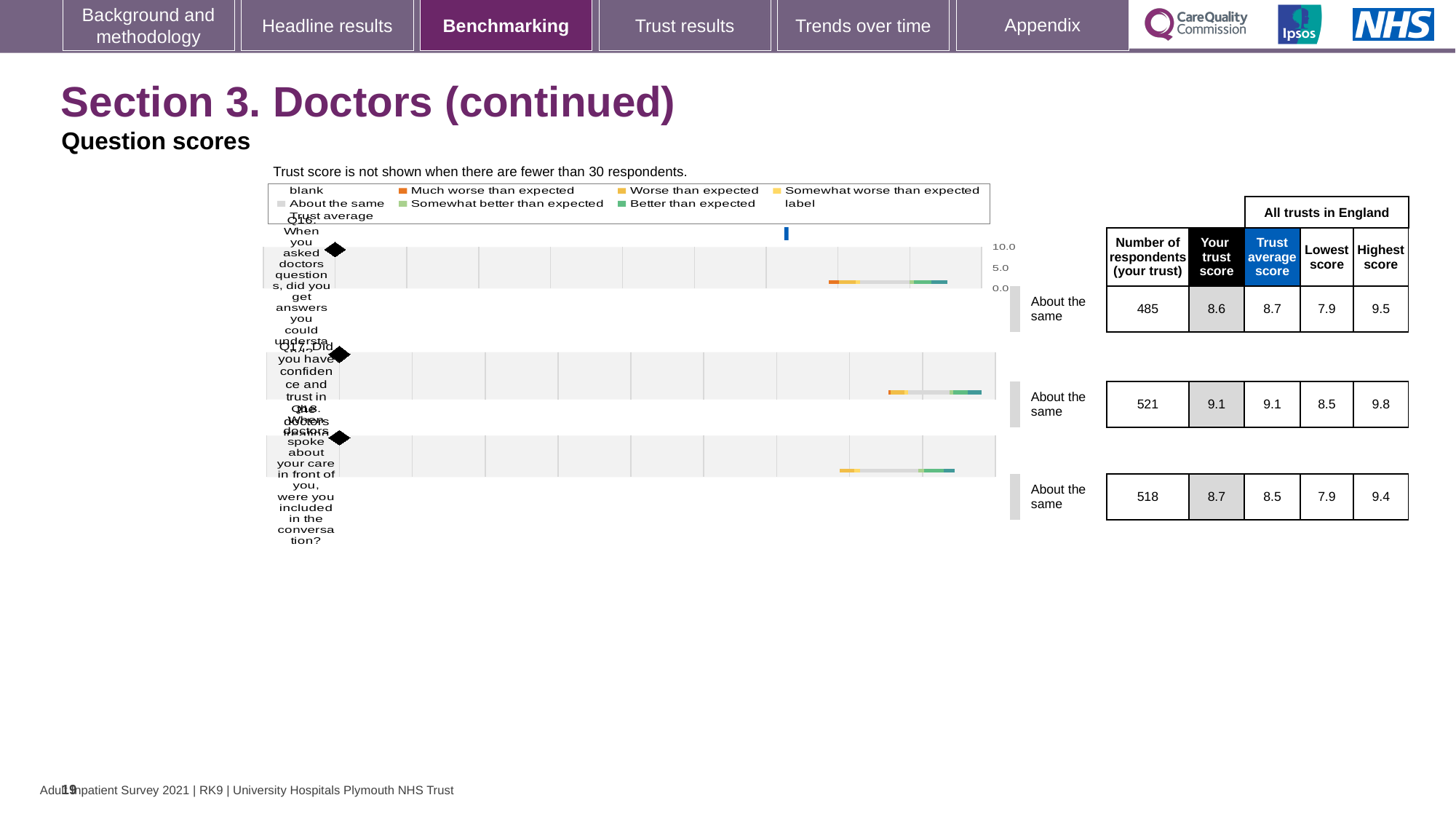
Which question has the fewest respondents from your trust? Q16 What is the highest score across all trusts in England for Q18 (being included in the conversation when doctors spoke about your care)? 9.4 What is the difference between the highest score and the lowest score for Q16? 1.6 What benchmark category is shown for Q16? About the same How many respondents from your trust answered Q16 (getting answers you could understand from doctors)? 485 Which question has the highest 'Your trust score'? Q17 How many questions are shown in the chart? 3 What is the lowest score across all trusts in England for Q17? 8.5 What is the difference between the trust average score and your trust score for Q16? 0.1 What is the 'Your trust score' value for Q17 (confidence and trust in the doctors)? 9.1 For Q18, which is larger: your trust score or the trust average score? Your trust score What kind of chart is used to show the question scores? Bar chart